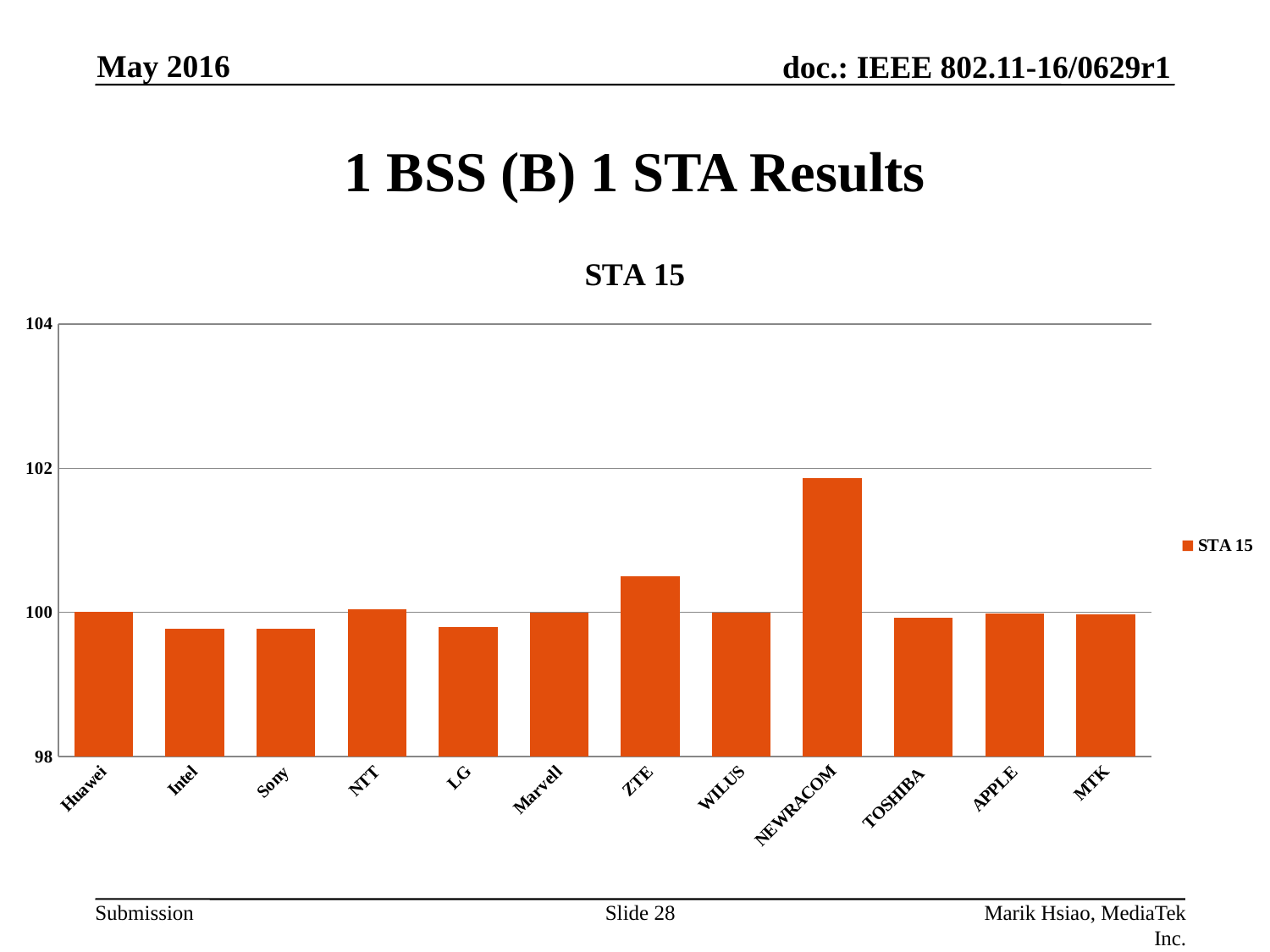
What is the title of the chart? STA 15 What series name is shown in the chart's legend? STA 15 Which category has the highest value in the chart? NEWRACOM Is the value for NEWRACOM greater or less than 102? less Is the value for ZTE greater or less than 100? greater Is the value for Sony greater or less than 100? less Which has the larger value, ZTE or Intel? ZTE How many categories are plotted along the x axis of the chart? 12 How many series does the chart's legend list? 1 What kind of chart is shown on the slide? bar chart Which has the larger value, NEWRACOM or ZTE? NEWRACOM